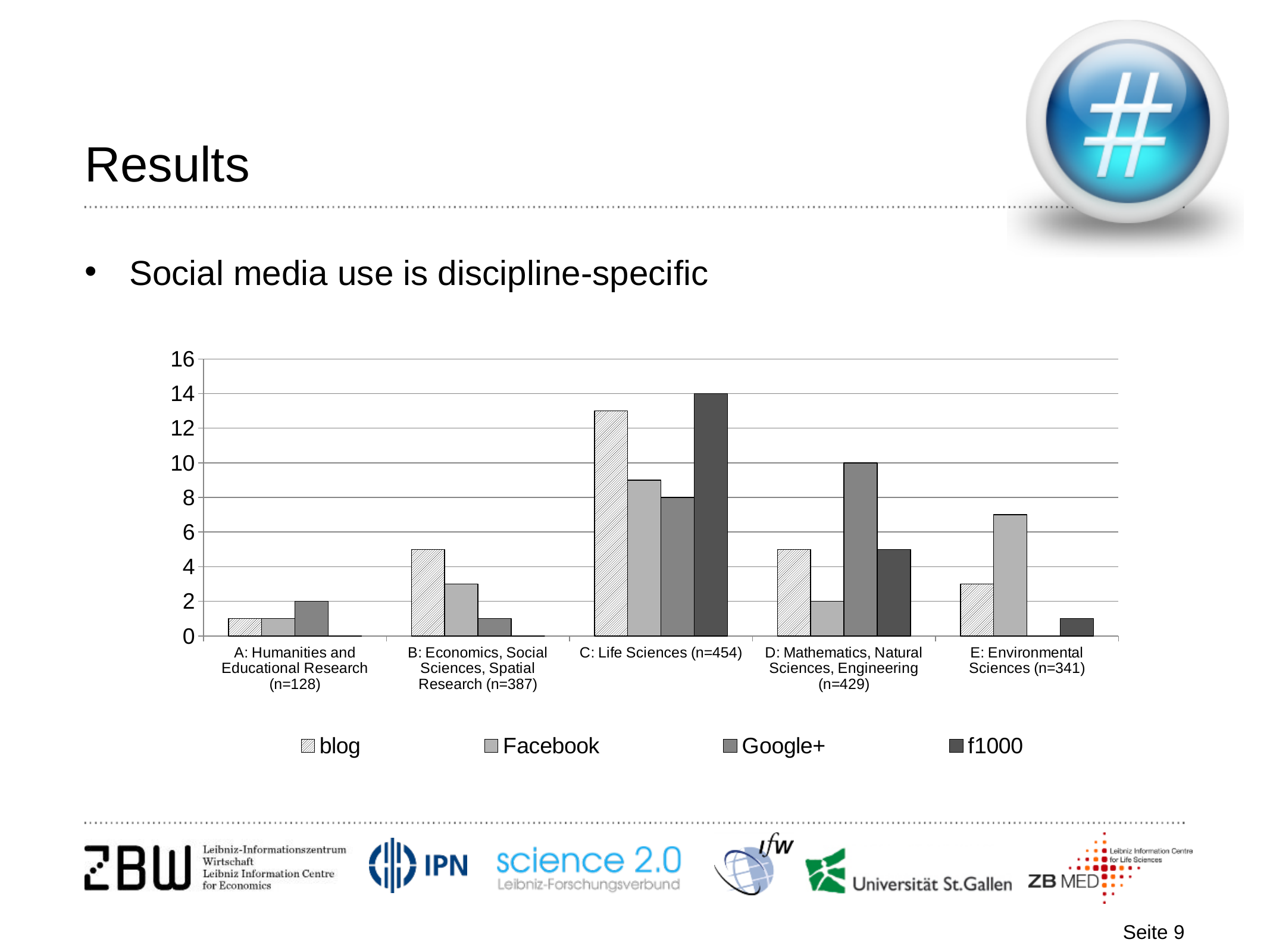
What is the value for f1000 in C: Life Sciences (n=454)? 14 What is the value for Google+ in D: Mathematics, Natural Sciences, Engineering (n=429)? 10 In D: Mathematics, Natural Sciences, Engineering (n=429), which is larger, the Google+ value or the Facebook value? Google+ How many discipline categories are shown on the x axis? 5 Is the blog value for C: Life Sciences (n=454) greater or less than 12? greater Which discipline has the highest blog value? C: Life Sciences (n=454) What is the value for Google+ in A: Humanities and Educational Research (n=128)? 2 What kind of chart is shown on the slide? bar chart Which series is shown with the darkest bars in the legend? f1000 How many series does the legend list? 4 Which discipline has the highest f1000 value? C: Life Sciences (n=454) Is the Facebook value for E: Environmental Sciences (n=341) greater or less than 6? greater